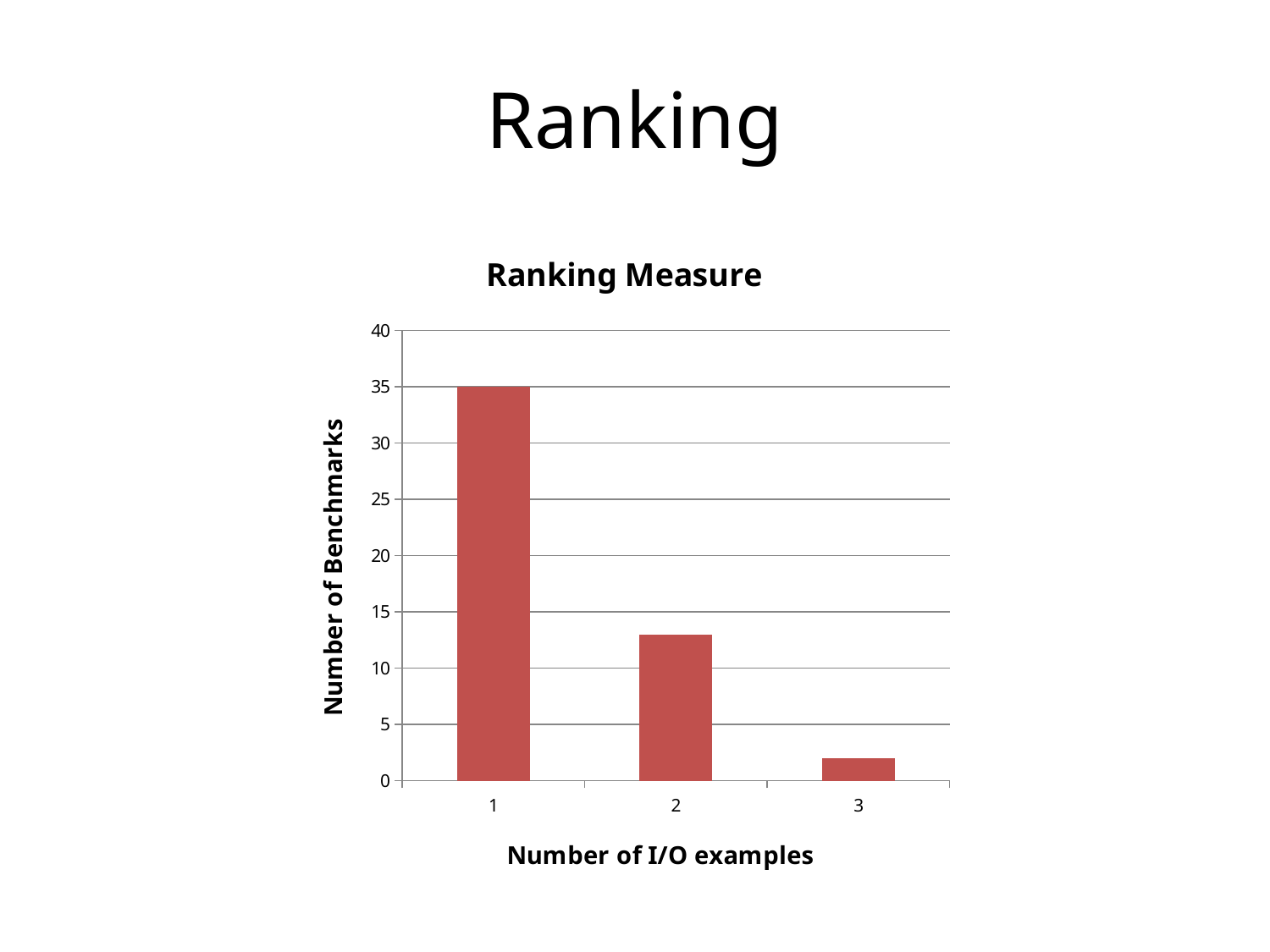
Is the number of benchmarks for 2 I/O examples greater or less than 10? greater What is the label of the y axis? Number of Benchmarks Do the values rise or fall as the number of I/O examples increases along the x axis? fall Is the number of benchmarks for 3 I/O examples greater or less than 5? less Which number of I/O examples has the highest number of benchmarks? 1 Which number of I/O examples has the lowest number of benchmarks? 3 Which has more benchmarks, 1 I/O example or 2 I/O examples? 1 What type of chart is shown on the slide? bar chart What is the number of benchmarks for 1 I/O example? 35 Is the number of benchmarks for 2 I/O examples greater or less than 15? less How many categories are shown on the x axis? 3 What is the title of the chart? Ranking Measure